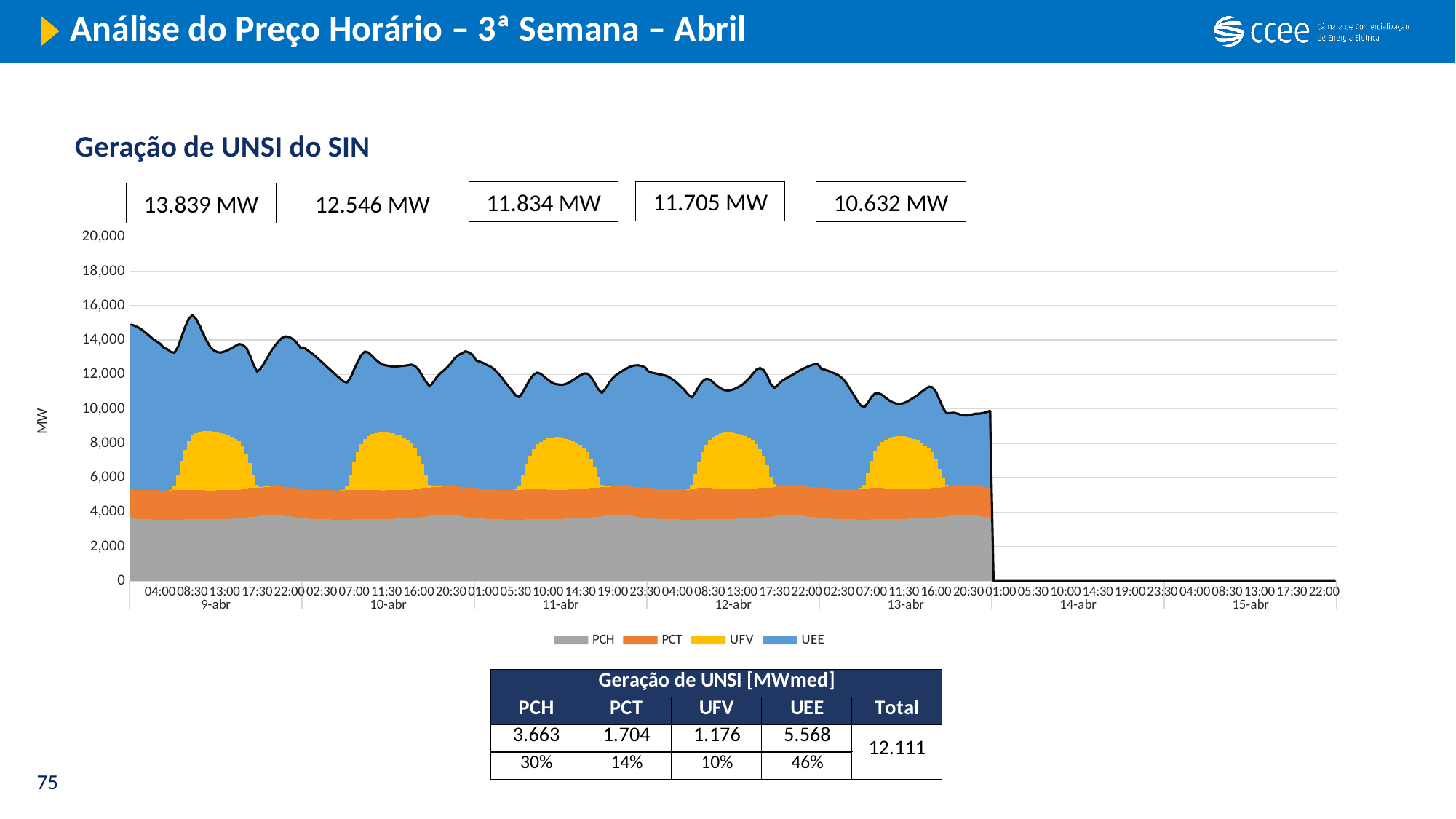
What kind of chart is used to show Geração de UNSI do SIN? Stacked bar chart with a line for the total What is the unit shown on the vertical axis of the Geração de UNSI do SIN chart? MW Is the highest peak of total generation on 9-abr greater or less than 14,000 MW? greater What is the difference between the daily average values shown for 9-abr and 10-abr? 1.293 MW Does the total generation in the Geração de UNSI do SIN chart rise or fall from 9-abr to 13-abr? Fall How many days are labelled along the x axis of the Geração de UNSI do SIN chart? 7 How many series does the legend of the Geração de UNSI do SIN chart list? 4 What daily average value is shown in the box above 9-abr in the Geração de UNSI do SIN chart? 13.839 MW What daily average value is shown in the box above 13-abr in the Geração de UNSI do SIN chart? 10.632 MW Which day has the highest daily average value shown in the boxes above the Geração de UNSI do SIN chart? 9-abr Is the total generation at the end of 13-abr greater or less than 12,000 MW? less Which series are listed in the legend of the Geração de UNSI do SIN chart? PCH, PCT, UFV, UEE